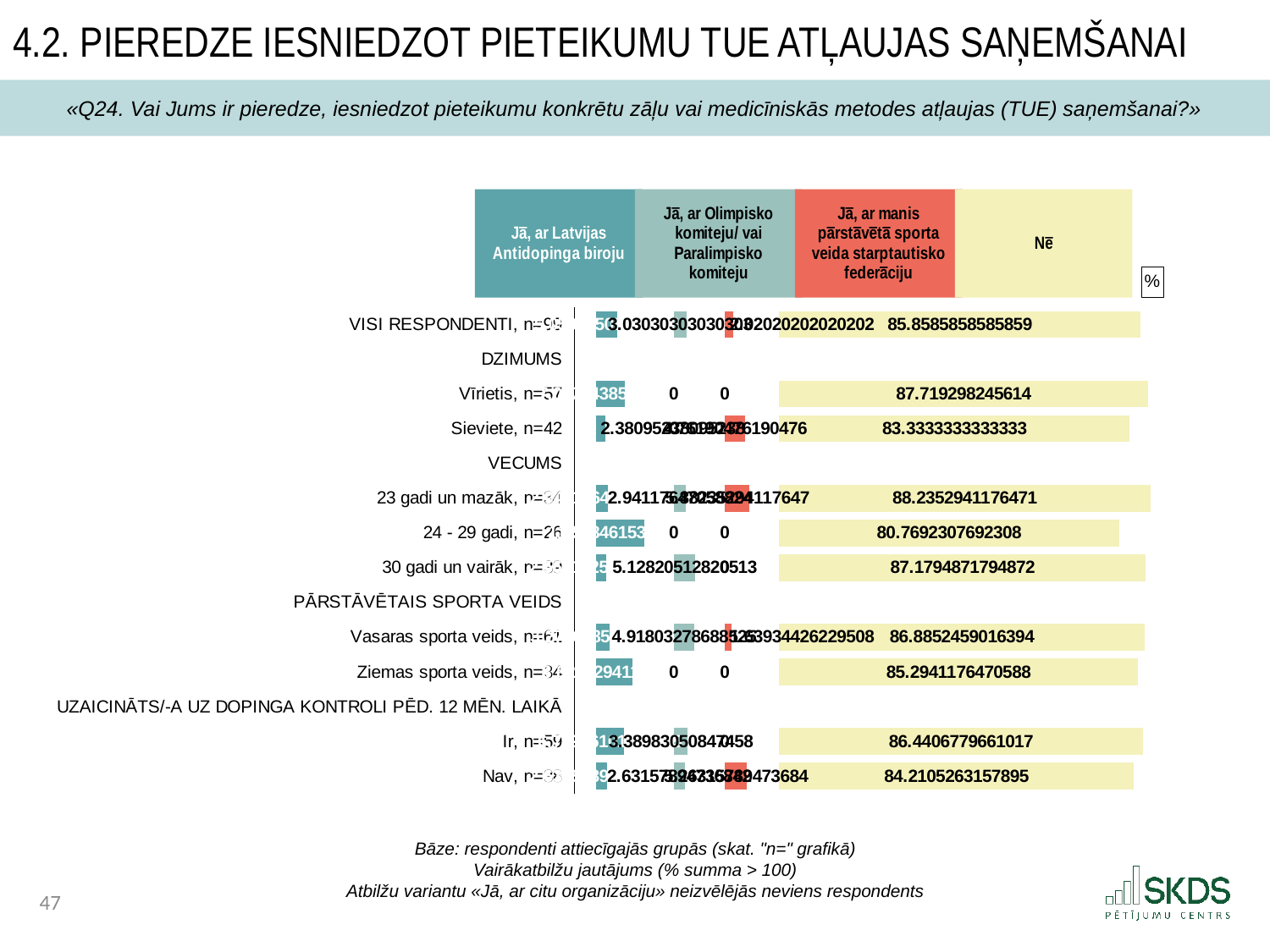
Which has a larger value for "Nē": Vīrietis, n=57 or Sieviete, n=42? Vīrietis, n=57 What is the value of "Jā, ar Olimpisko komiteju/ vai Paralimpisko komiteju" for Vīrietis, n=57? 0 How many respondent groups (bars) are plotted in the chart? 10 What is the value of "Nē" for Sieviete, n=42? 83.3333333333333 How many series does the legend list? 4 What kind of chart is shown on the slide? Stacked horizontal bar chart What is the difference between the "Nē" values for Vīrietis, n=57 and Sieviete, n=42? 4.3859649122807 Which category has the highest value for "Nē"? 23 gadi un mazāk, n=34 What is the value of "Nē" for Vīrietis, n=57? 87.719298245614 What is the value of "Nē" for VISI RESPONDENTI, n=99? 85.8585858585859 Which category has the lowest value for "Nē"? 24 - 29 gadi, n=26 What is the value of "Nē" for Ziemas sporta veids, n=34? 85.2941176470588